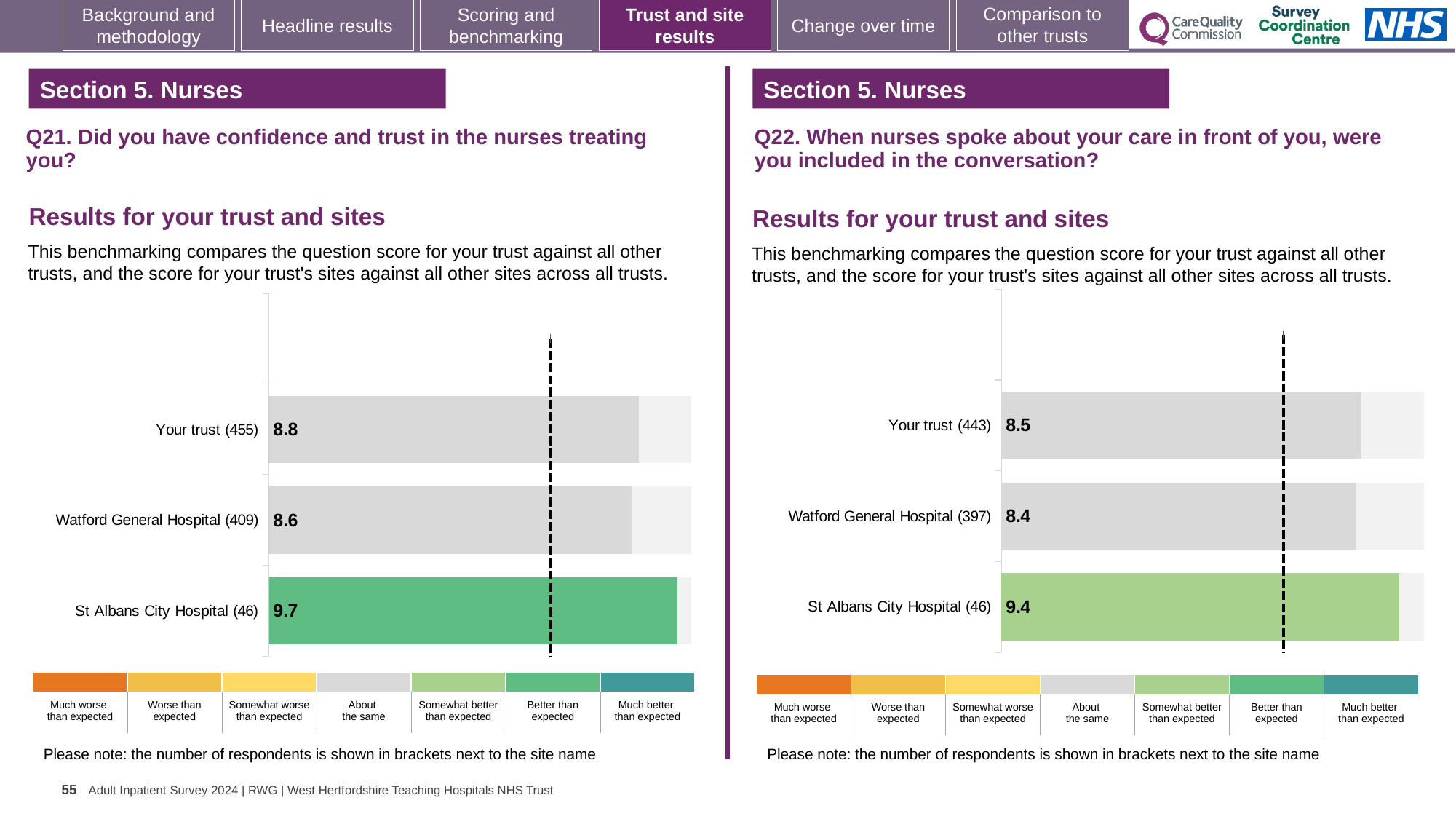
In the Q22 chart (right), which has the larger score, Your trust or Watford General Hospital? Your trust How many bars are shown in the Q21 chart (left)? 3 In the Q22 chart (right), what is the score for Watford General Hospital? 8.4 In the Q21 chart (left), what is the difference between the St Albans City Hospital score and the Watford General Hospital score? 1.1 What type of chart is used for the Q22 results (right)? Bar chart In the Q21 chart (left), which site or trust has the highest score? St Albans City Hospital In the Q21 chart (left), what is the score for St Albans City Hospital? 9.7 In the Q22 chart (right), what is the score for St Albans City Hospital? 9.4 In the Q21 chart (left), what is the score for Your trust? 8.8 In the Q22 chart (right), what is the difference between the Your trust score and the St Albans City Hospital score? 0.9 In the Q22 chart (right), which site or trust has the lowest score? Watford General Hospital In the Q21 chart (left), how many respondents are shown in brackets for Watford General Hospital? 409